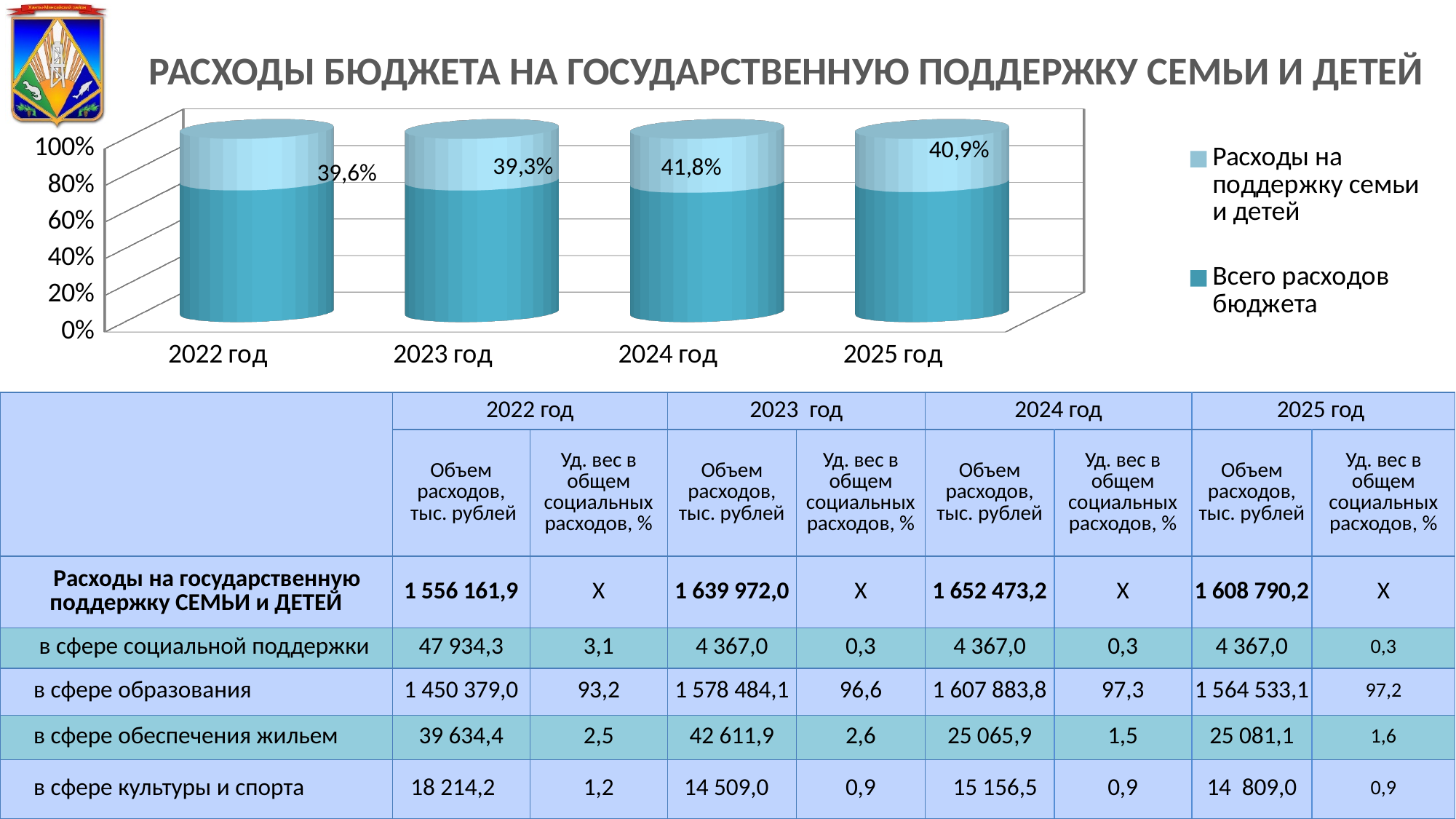
What value is labelled for 2025 год in the chart? 40,9% What value is labelled for 2024 год in the chart? 41,8% How many years are shown on the x axis of the chart? 4 Which year has the lowest labelled percentage in the chart? 2023 год How many series does the chart legend list? 2 What is the difference between the labelled values for 2024 год and 2023 год? 2,5% What value is labelled for 2022 год in the chart? 39,6% What kind of chart is shown on the slide? bar chart What value is labelled for 2023 год in the chart? 39,3% Which legend entry is shown with the darker colour in the chart? Всего расходов бюджета Which has the larger labelled value, 2022 год or 2025 год? 2025 год Which year has the highest labelled percentage in the chart? 2024 год